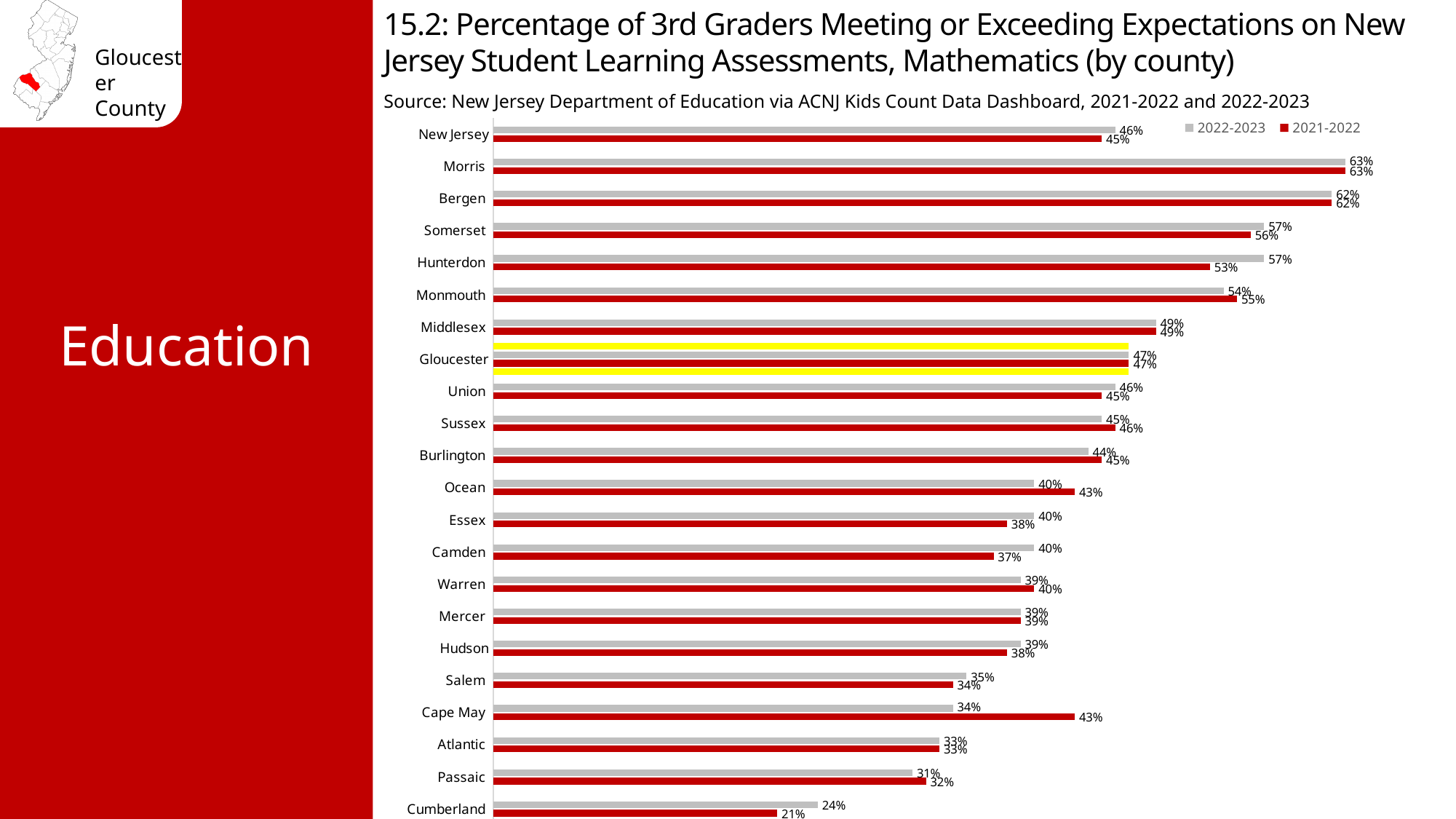
What is the difference between Hunterdon's 2022-2023 value and its 2021-2022 value? 4% What type of chart is shown on the slide? bar chart What is the 2022-2023 value for Hunterdon? 57% How many series does the legend list? 2 Which county has the highest 2022-2023 value? Morris What is the difference between Cumberland's 2022-2023 value and its 2021-2022 value? 3% How many categories (counties plus New Jersey) are plotted on the chart? 22 What is the 2022-2023 value for Gloucester? 47% Which is larger for Cape May: the 2022-2023 value or the 2021-2022 value? 2021-2022 Which colour represents the 2021-2022 series? red What is the 2021-2022 value for Cape May? 43% Which county has the lowest 2021-2022 value? Cumberland